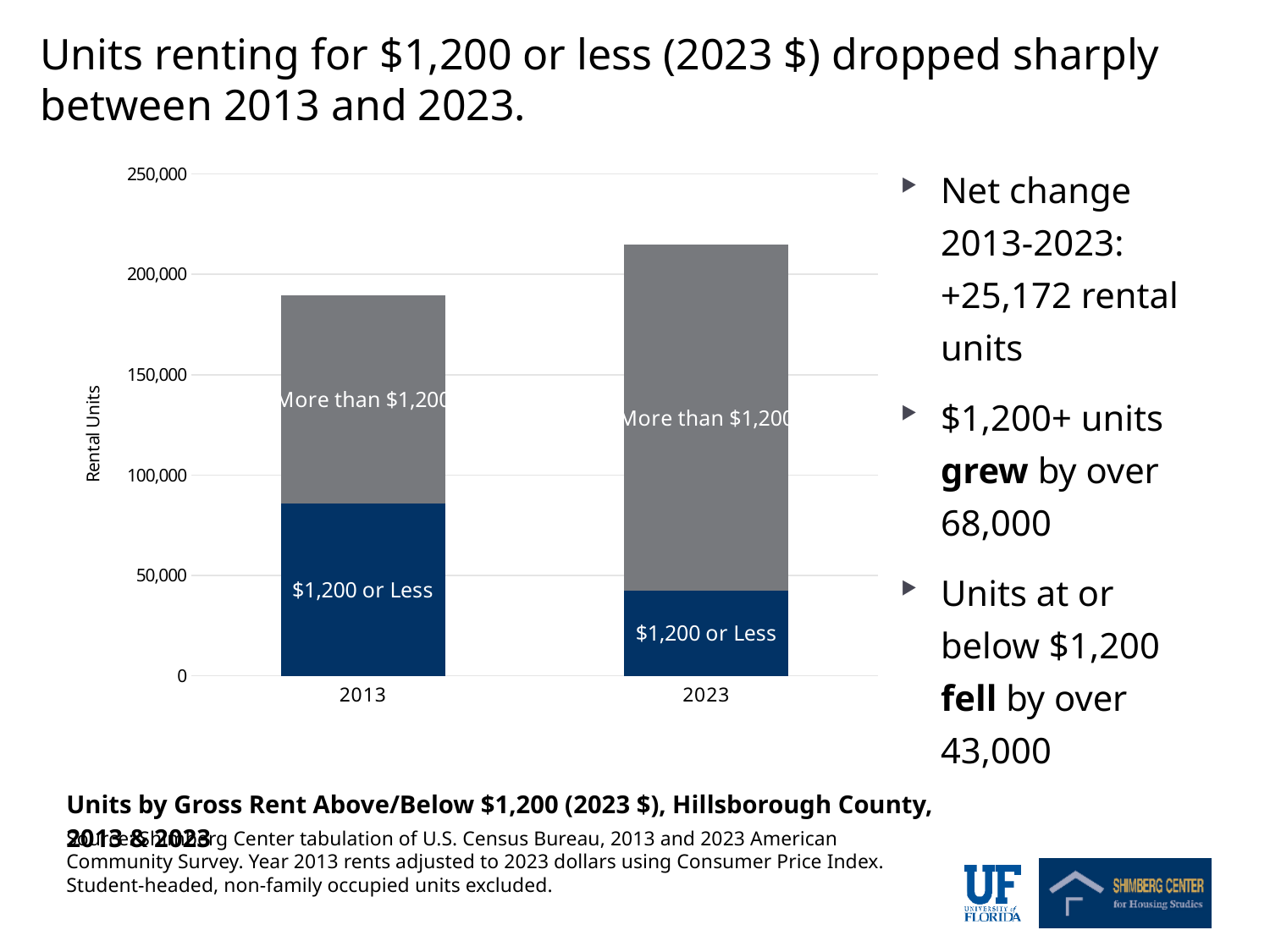
How many series are stacked in each bar? 2 Is the total height of the 2013 bar greater or less than 200,000? less What is the label on the vertical axis of the chart? Rental Units What kind of chart is shown on the slide? Stacked bar chart Does the "$1,200 or Less" segment rise or fall from 2013 to 2023? Fall Is the total height of the 2023 bar greater or less than 200,000? greater Is the value for "$1,200 or Less" in 2013 greater or less than 50,000? greater How many years (categories) are plotted on the x axis? 2 Which year has the larger number of units renting for $1,200 or less, 2013 or 2023? 2013 Which year has the taller total bar, 2013 or 2023? 2023